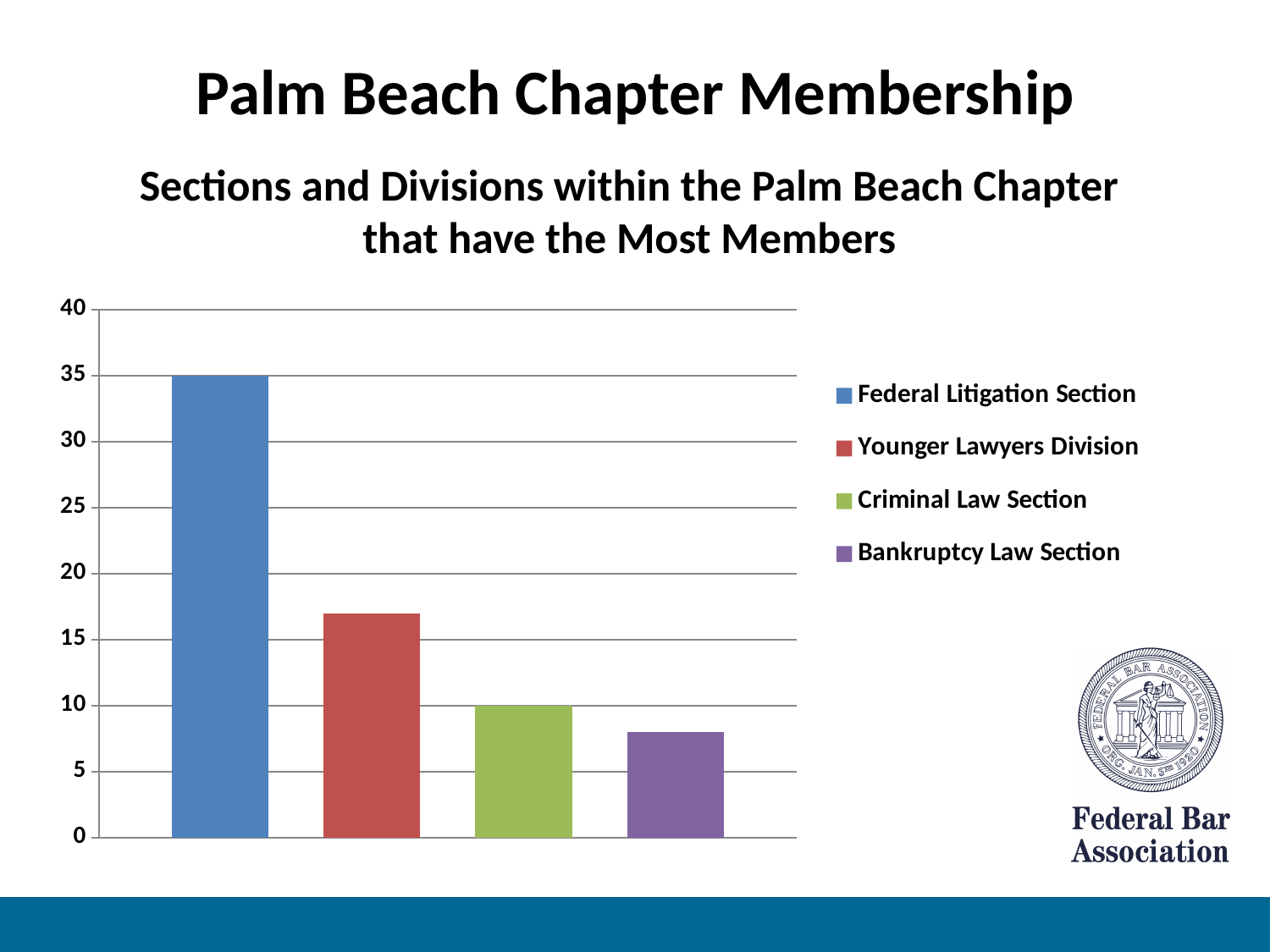
Which section or division has the fewest members according to the chart? Bankruptcy Law Section Is the value for the Younger Lawyers Division greater or less than 15? greater What type of chart is shown on the slide? bar chart Which section or division has the most members according to the chart? Federal Litigation Section How many bars are plotted in the chart? 4 What is the membership value shown for the Federal Litigation Section? 35 Which has more members, the Younger Lawyers Division or the Criminal Law Section? Younger Lawyers Division How many entries does the chart's legend list? 4 Is the value for the Bankruptcy Law Section greater or less than 10? less What colour is the bar for the Bankruptcy Law Section? purple Do the bar values rise or fall from left to right across the chart? fall What is the membership value shown for the Criminal Law Section? 10